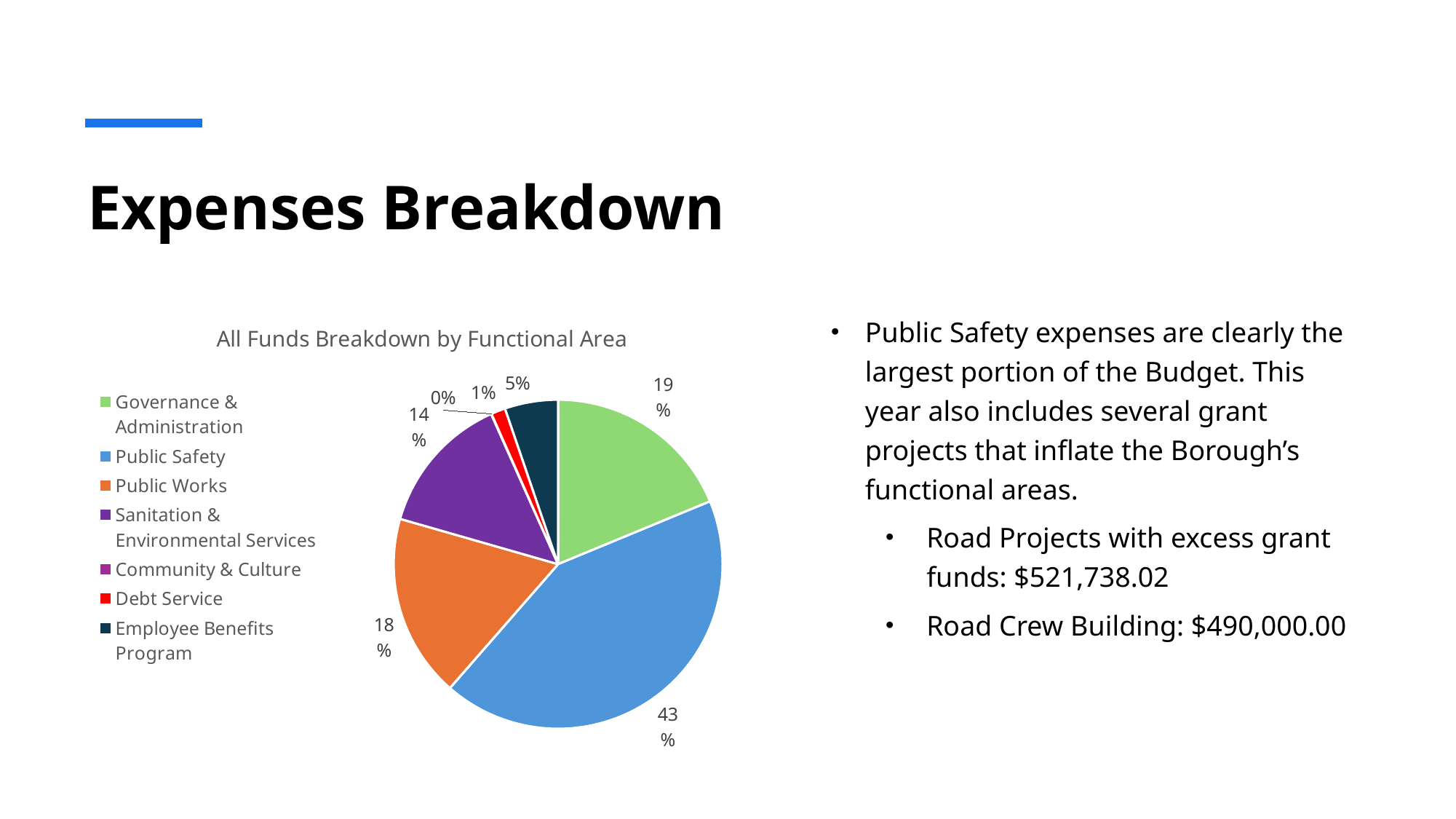
What is the chart's title? All Funds Breakdown by Functional Area What share of the pie does Public Works represent? 18% What type of chart is shown on the slide? pie chart How many functional areas does the legend list? 7 What share of the pie does Governance & Administration represent? 19% Which functional area has the smallest share of the pie? Community & Culture What share of the pie does Employee Benefits Program represent? 5% What is the difference in percentage points between Public Safety and Governance & Administration? 24 Which functional area has the largest share of the pie? Public Safety